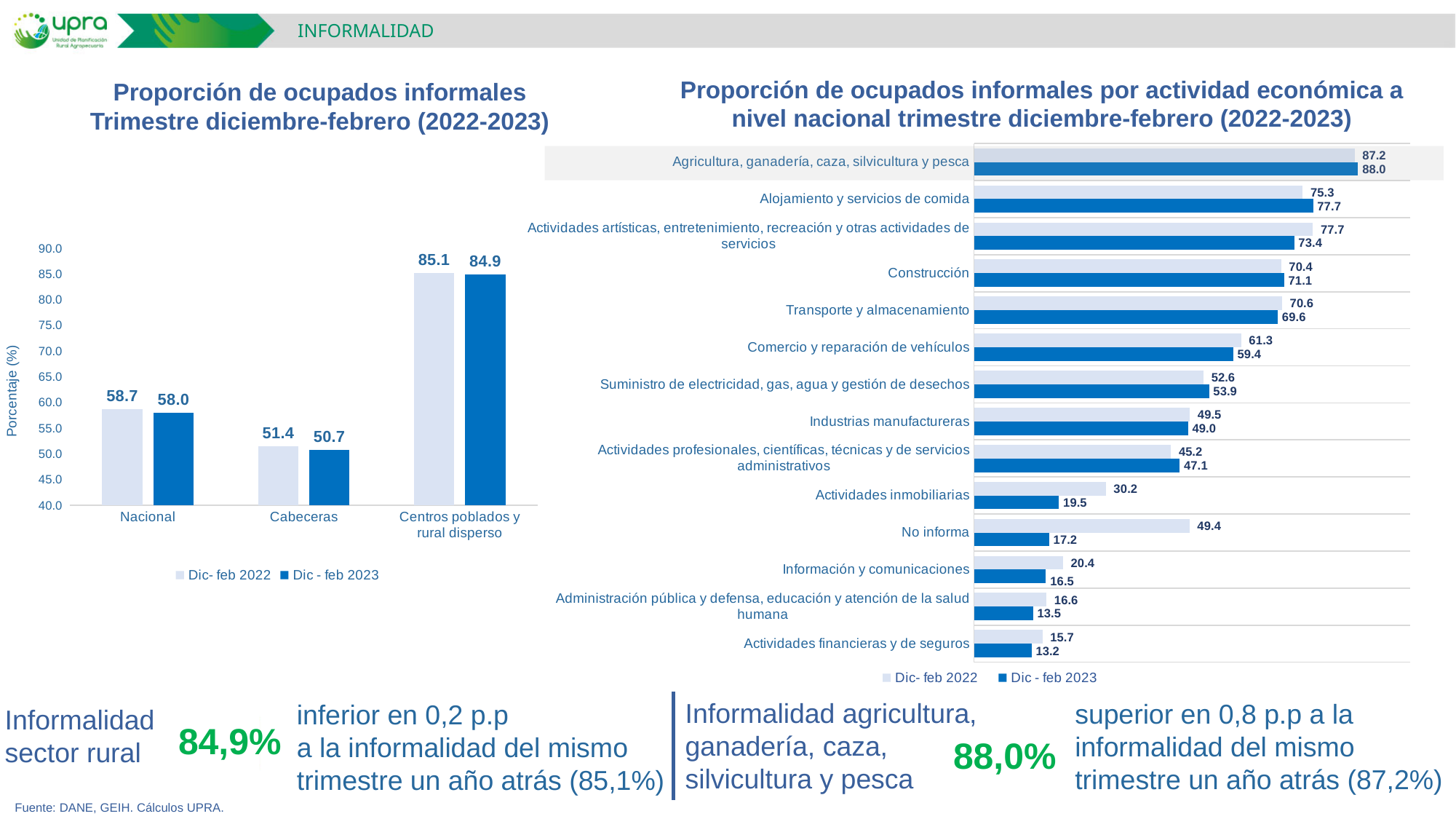
What type of chart is the right chart 'Proporción de ocupados informales por actividad económica a nivel nacional trimestre diciembre-febrero (2022-2023)'? Bar chart In the left chart 'Proporción de ocupados informales Trimestre diciembre-febrero (2022-2023)', which category has the highest value in Dic - feb 2023? Centros poblados y rural disperso In the right chart 'Proporción de ocupados informales por actividad económica a nivel nacional trimestre diciembre-febrero (2022-2023)', which activity has the lowest Dic - feb 2023 value? Actividades financieras y de seguros In the left chart 'Proporción de ocupados informales Trimestre diciembre-febrero (2022-2023)', what is the value for Nacional in Dic - feb 2023? 58.0 In the left chart 'Proporción de ocupados informales Trimestre diciembre-febrero (2022-2023)', what is the difference between the Dic- feb 2022 and Dic - feb 2023 values for Centros poblados y rural disperso? 0.2 In the right chart 'Proporción de ocupados informales por actividad económica a nivel nacional trimestre diciembre-febrero (2022-2023)', what is the Dic - feb 2023 value for Construcción? 71.1 In the left chart 'Proporción de ocupados informales Trimestre diciembre-febrero (2022-2023)', what is the value for Cabeceras in Dic- feb 2022? 51.4 In the right chart 'Proporción de ocupados informales por actividad económica a nivel nacional trimestre diciembre-febrero (2022-2023)', what is the difference between the Dic- feb 2022 and Dic - feb 2023 values for No informa? 32.2 In the left chart 'Proporción de ocupados informales Trimestre diciembre-febrero (2022-2023)', how many series does the legend list? 2 In the right chart 'Proporción de ocupados informales por actividad económica a nivel nacional trimestre diciembre-febrero (2022-2023)', what is the Dic- feb 2022 value for Actividades inmobiliarias? 30.2 In the left chart 'Proporción de ocupados informales Trimestre diciembre-febrero (2022-2023)', how many categories are shown on the x axis? 3 In the right chart 'Proporción de ocupados informales por actividad económica a nivel nacional trimestre diciembre-febrero (2022-2023)', which is larger for Comercio y reparación de vehículos: the Dic- feb 2022 value or the Dic - feb 2023 value? Dic- feb 2022